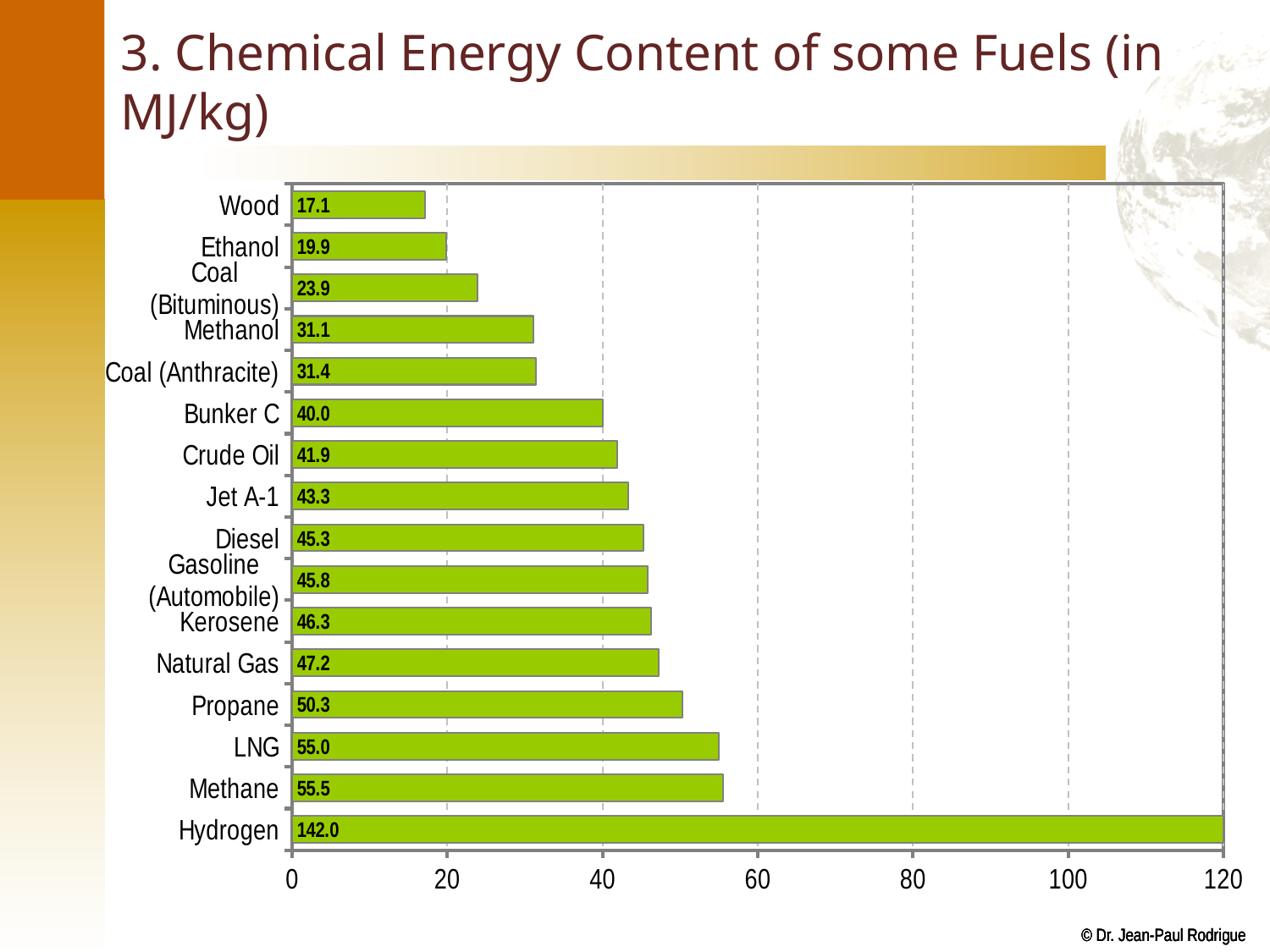
Which fuel has the highest chemical energy content? Hydrogen Is the value for Bunker C greater or less than 60? less How many fuels are shown in the chart? 16 Which fuel has the lowest chemical energy content? Wood What is the chemical energy content of Hydrogen? 142.0 What is the difference between the values for Propane and Wood? 33.2 Which has a higher value, Natural Gas or Kerosene? Natural Gas What is the difference between the values for Methane and LNG? 0.5 What is the value shown for Coal (Anthracite)? 31.4 What is the value shown for Crude Oil? 41.9 What kind of chart is shown on the slide? bar chart What is the title of the slide? 3. Chemical Energy Content of some Fuels (in MJ/kg)